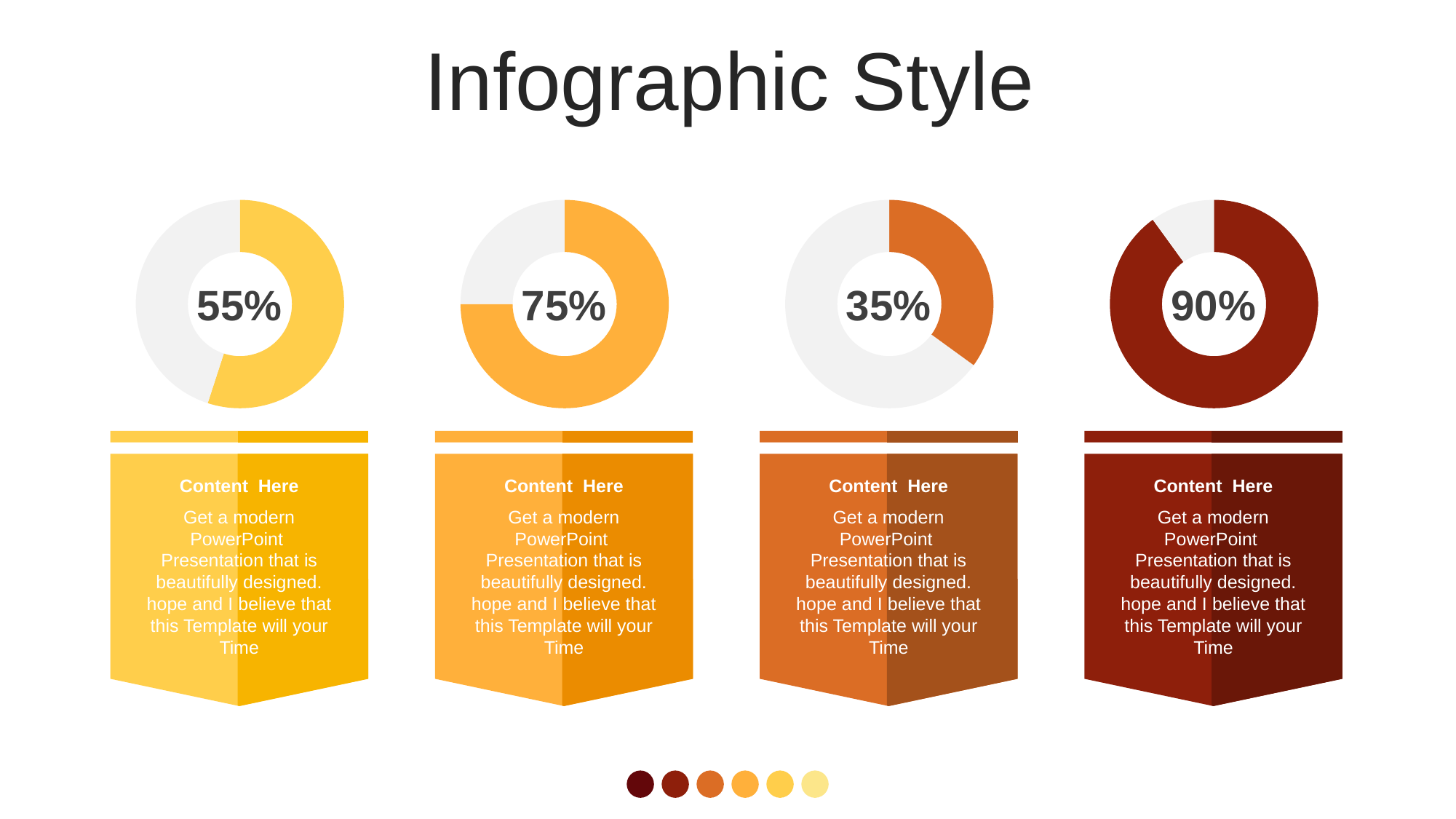
What percentage is shown in the centre of the second donut chart from the left? 75% Which shows a larger percentage, the leftmost donut chart or the second donut chart from the left? The second donut chart (75%) Which of the four donut charts shows the highest percentage? The rightmost (90%) What percentage is shown in the centre of the rightmost donut chart? 90% What colour is the filled portion of the rightmost donut chart? Dark red What is the difference between the percentage in the rightmost donut chart and the percentage in the leftmost donut chart? 35% What percentage is shown in the centre of the third donut chart from the left? 35% How many donut charts are on the slide? 4 Which of the four donut charts shows the lowest percentage? The third from the left (35%) What percentage is shown in the centre of the leftmost donut chart? 55% What kind of chart is used to display the percentages on the slide? Donut chart What is the difference between the percentage in the second donut chart and the percentage in the third donut chart? 40%